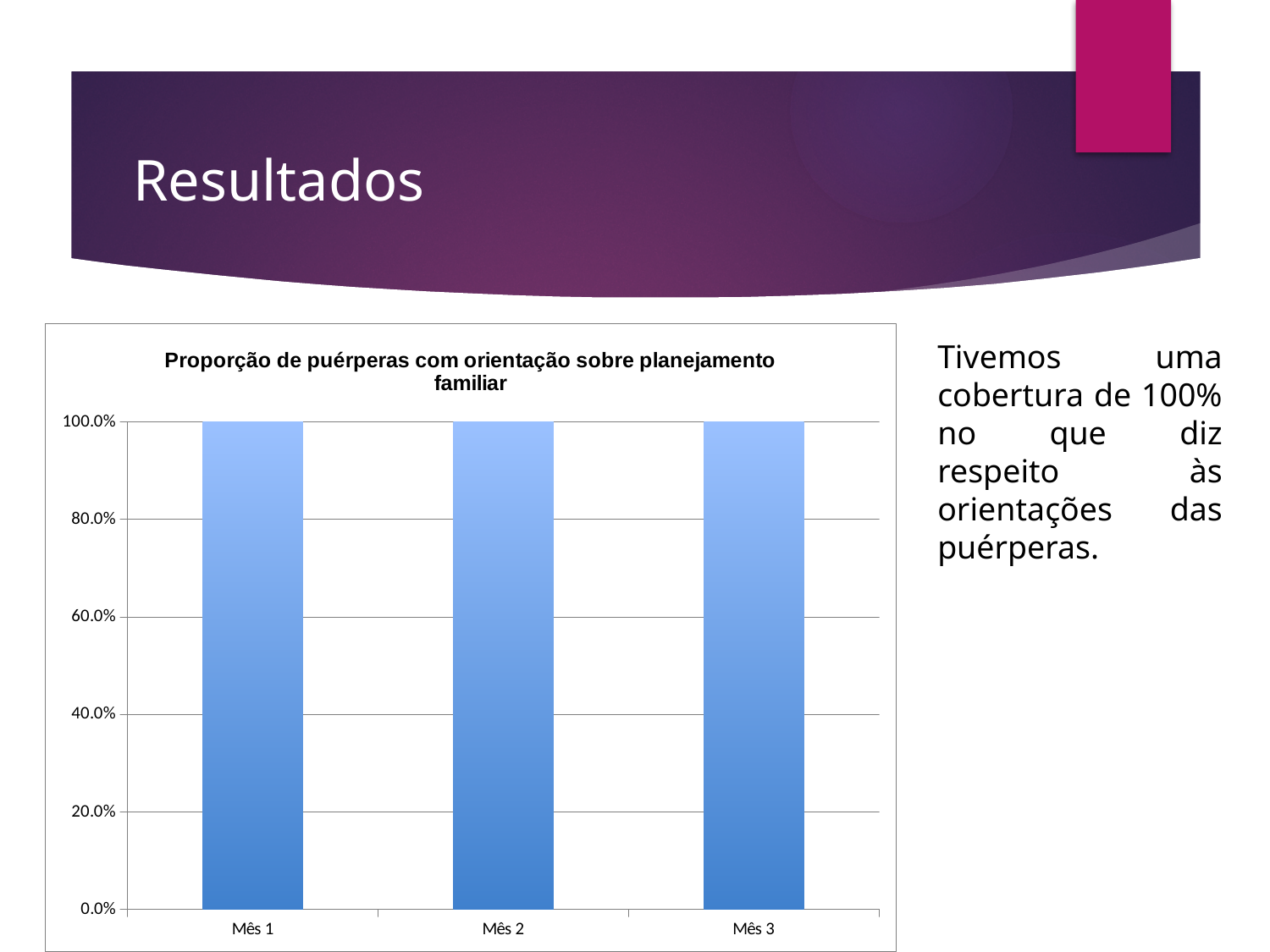
What colour are the bars in the chart? Blue What is the title of the chart? Proporção de puérperas com orientação sobre planejamento familiar What kind of chart is shown on the slide? Bar chart What is the value for Mês 2? 100.0% How many categories are shown on the x axis? 3 What is the value for Mês 3? 100.0% Do the values rise, fall or stay the same from Mês 1 to Mês 3? Stay the same Is the value for Mês 2 greater or less than 80.0%? greater What is the highest value shown on the y axis? 100.0% What is the difference between the values for Mês 1 and Mês 3? 0.0% Is the value for Mês 3 greater or less than 60.0%? greater What is the value for Mês 1? 100.0%